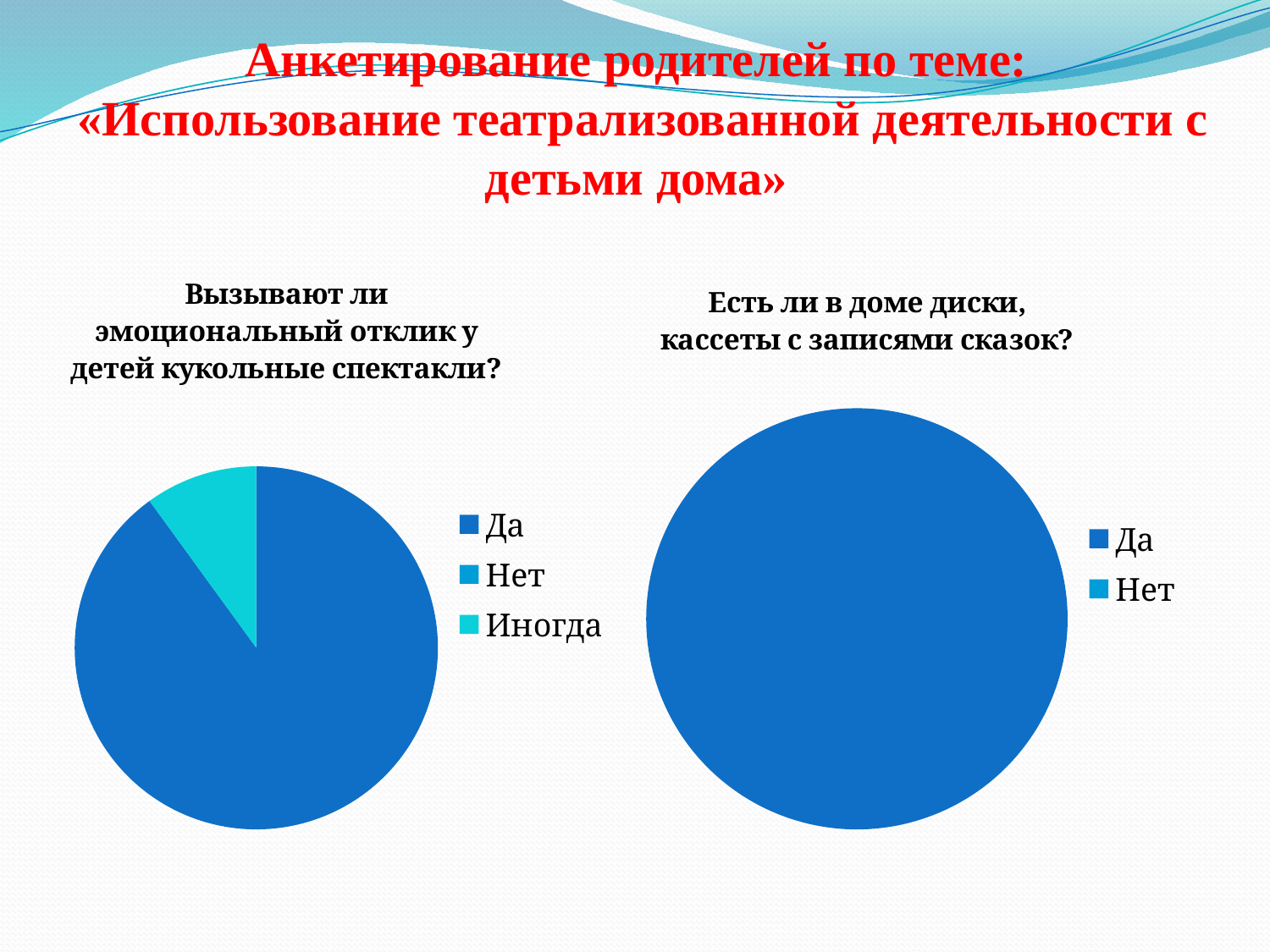
What is the title of the right pie chart on the slide? Есть ли в доме диски, кассеты с записями сказок? How many pie charts are shown on the slide? 2 In the right chart («Есть ли в доме диски, кассеты с записями сказок?»), which category has the largest slice? Да How many entries does the legend of the right chart («Есть ли в доме диски, кассеты с записями сказок?») list? 2 What kind of chart is the right chart titled «Есть ли в доме диски, кассеты с записями сказок?»? pie chart In the left chart («Вызывают ли эмоциональный отклик у детей кукольные спектакли?»), which legend entry is shown in the lightest (cyan) colour? Иногда In the left chart («Вызывают ли эмоциональный отклик у детей кукольные спектакли?»), which category has the largest slice? Да How many entries does the legend of the left chart («Вызывают ли эмоциональный отклик у детей кукольные спектакли?») list? 3 What kind of chart is the left chart titled «Вызывают ли эмоциональный отклик у детей кукольные спектакли?»? pie chart In the left chart («Вызывают ли эмоциональный отклик у детей кукольные спектакли?»), which slice is larger: Да or Иногда? Да